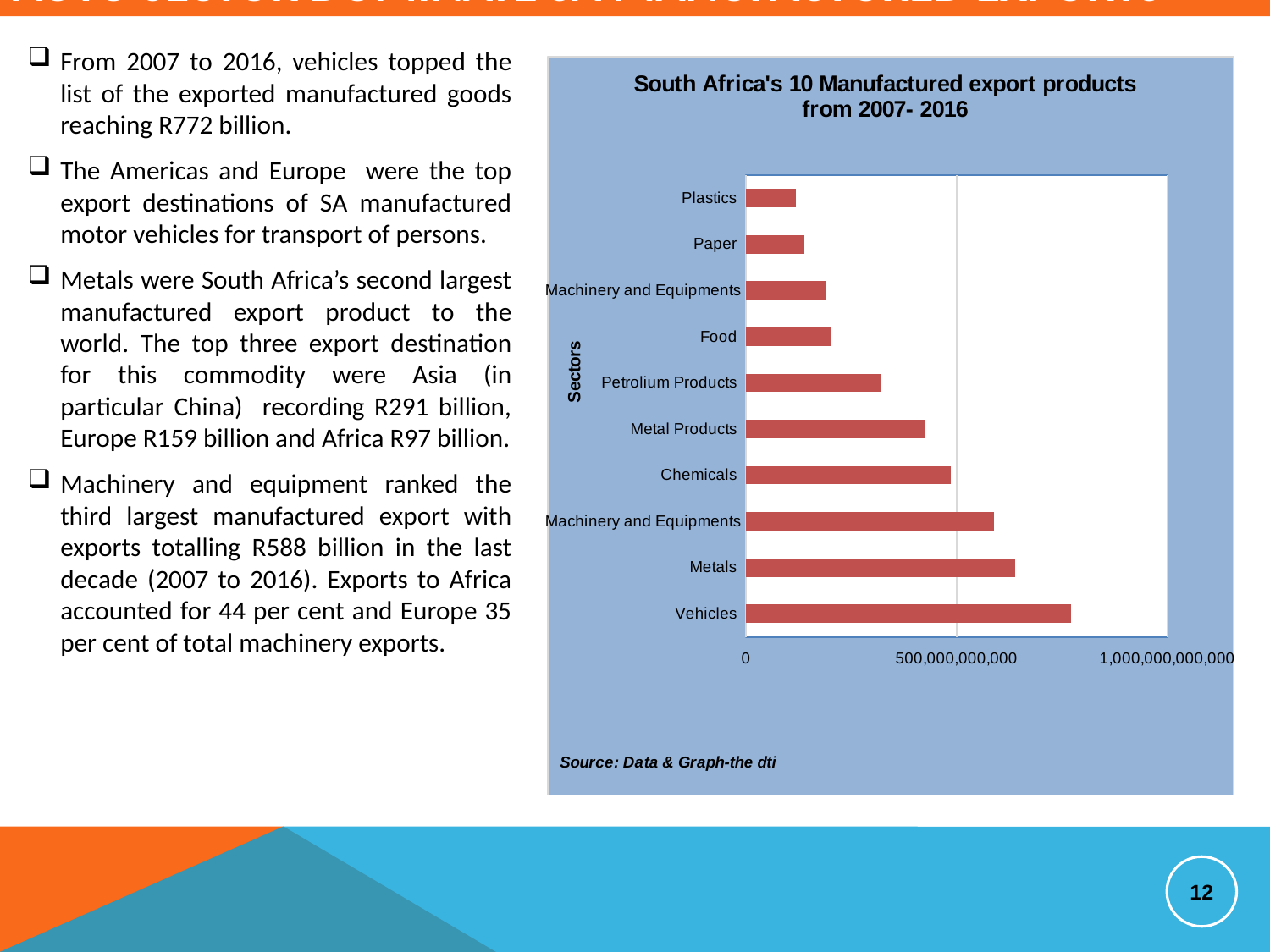
What is the label on the vertical axis of the chart? Sectors How many sectors are plotted in the chart? 10 What is the title of the chart? South Africa's 10 Manufactured export products from 2007- 2016 Is the value for Metals greater or less than 500,000,000,000? greater Is the value for Vehicles greater or less than 500,000,000,000? greater Is the value for Petrolium Products greater or less than 500,000,000,000? less Which is larger, the value for Vehicles or the value for Metals? Vehicles Which sector has the highest export value in the chart? Vehicles What kind of chart is shown on the slide? bar chart Which is larger, the value for Metal Products or the value for Petrolium Products? Metal Products Which sector has the lowest export value in the chart? Plastics